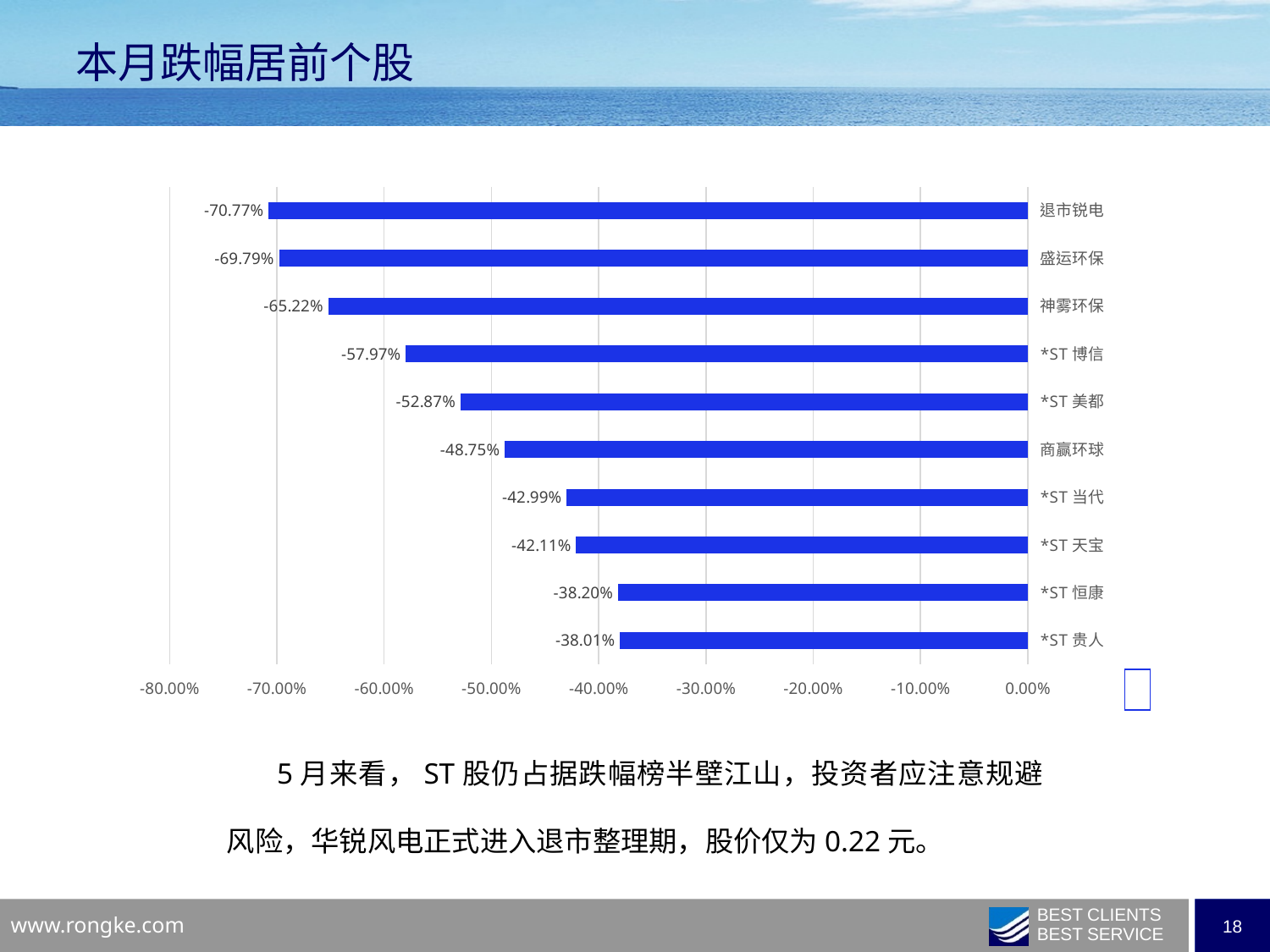
Which stock has the smallest decline (least negative value) on the chart? *ST 贵人 What is the value shown for *ST 恒康? -38.20% What is the title of the slide containing the chart? 本月跌幅居前个股 What kind of chart is shown on the slide? Bar chart What is the value shown for 退市锐电? -70.77% What is the value shown for *ST 美都? -52.87% What is the difference in percentage points between the values for 神雾环保 and *ST 博信? 7.25 percentage points What is the difference in percentage points between the values for 退市锐电 and 盛运环保? 0.98 percentage points What is the value shown for 商赢环球? -48.75% Which stock fell more this month, *ST 当代 or *ST 天宝? *ST 当代 How many stocks are shown on the chart? 10 Which stock has the largest decline (most negative value) on the chart? 退市锐电